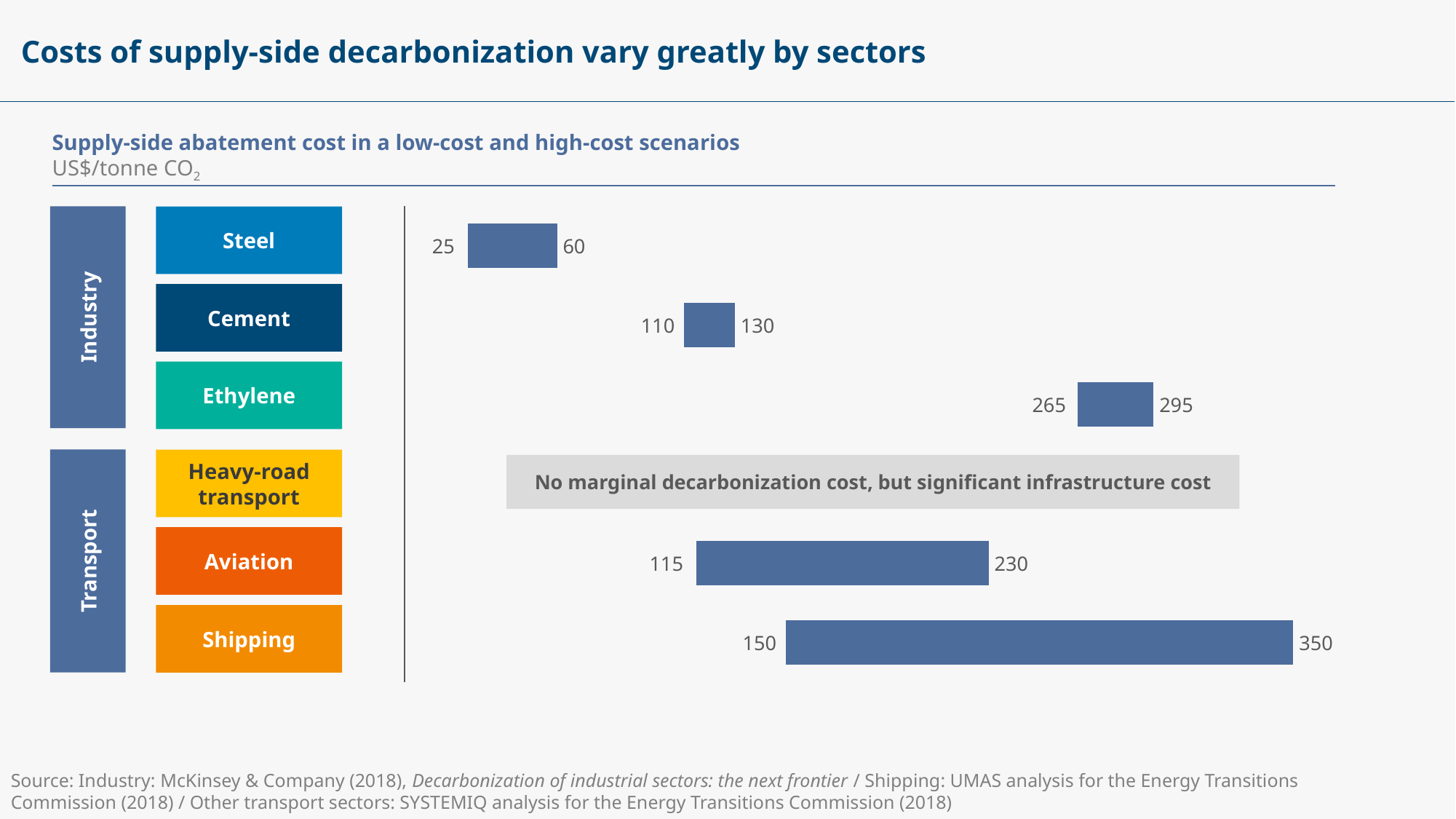
What is the unit of the abatement cost shown in the chart? US$/tonne CO2 What is the difference between the high-cost and low-cost abatement cost for Shipping? 200 What is the high-cost scenario abatement cost for Shipping? 350 What is the high-cost scenario abatement cost for Cement? 130 What is the difference between the high-cost and low-cost abatement cost for Ethylene? 30 What is the low-cost scenario abatement cost for Steel? 25 Which sector has the highest high-cost scenario abatement cost? Shipping What kind of chart is shown on the slide? Bar chart Which has a higher high-cost scenario abatement cost, Aviation or Ethylene? Ethylene What is the low-cost scenario abatement cost for Aviation? 115 How many sectors are listed in the chart? 6